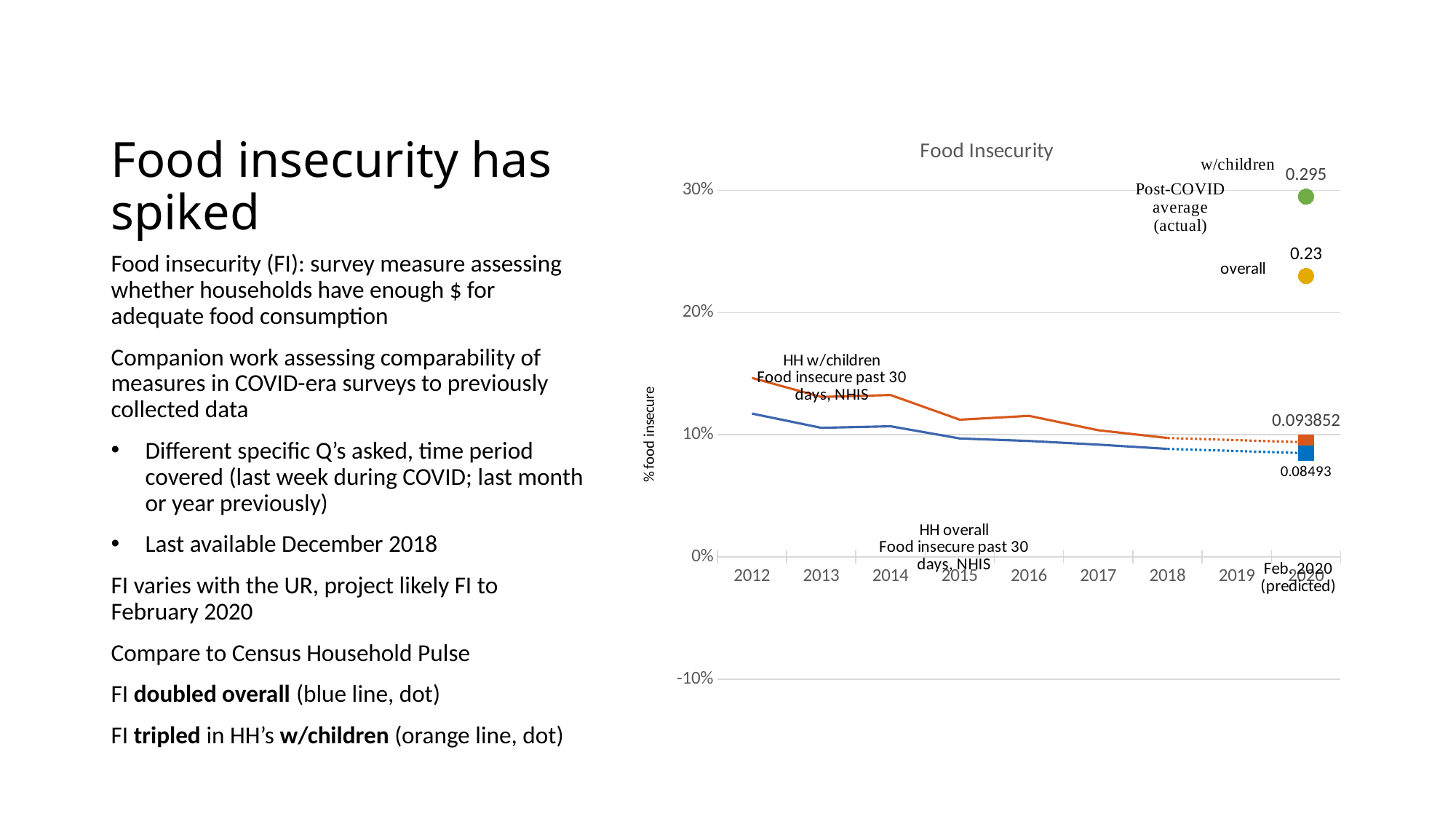
What is the predicted Feb. 2020 value for HH overall (blue line)? 0.08493 In 2012, which line is higher: HH w/children or HH overall? HH w/children What is the difference between the post-COVID average for households w/children and for households overall? 0.065 What is the post-COVID average (actual) value for households w/children? 0.295 Is the 2012 value for HH w/children greater or less than 10%? greater What is the post-COVID average (actual) value for households overall? 0.23 What is the label on the vertical axis? % food insecure What is the predicted Feb. 2020 value for HH w/children (orange line)? 0.093852 What kind of chart is shown on the slide? line chart Does the HH w/children line rise or fall from 2012 to 2018? fall Is the 2018 value for HH overall greater or less than 10%? less What is the title of the chart? Food Insecurity